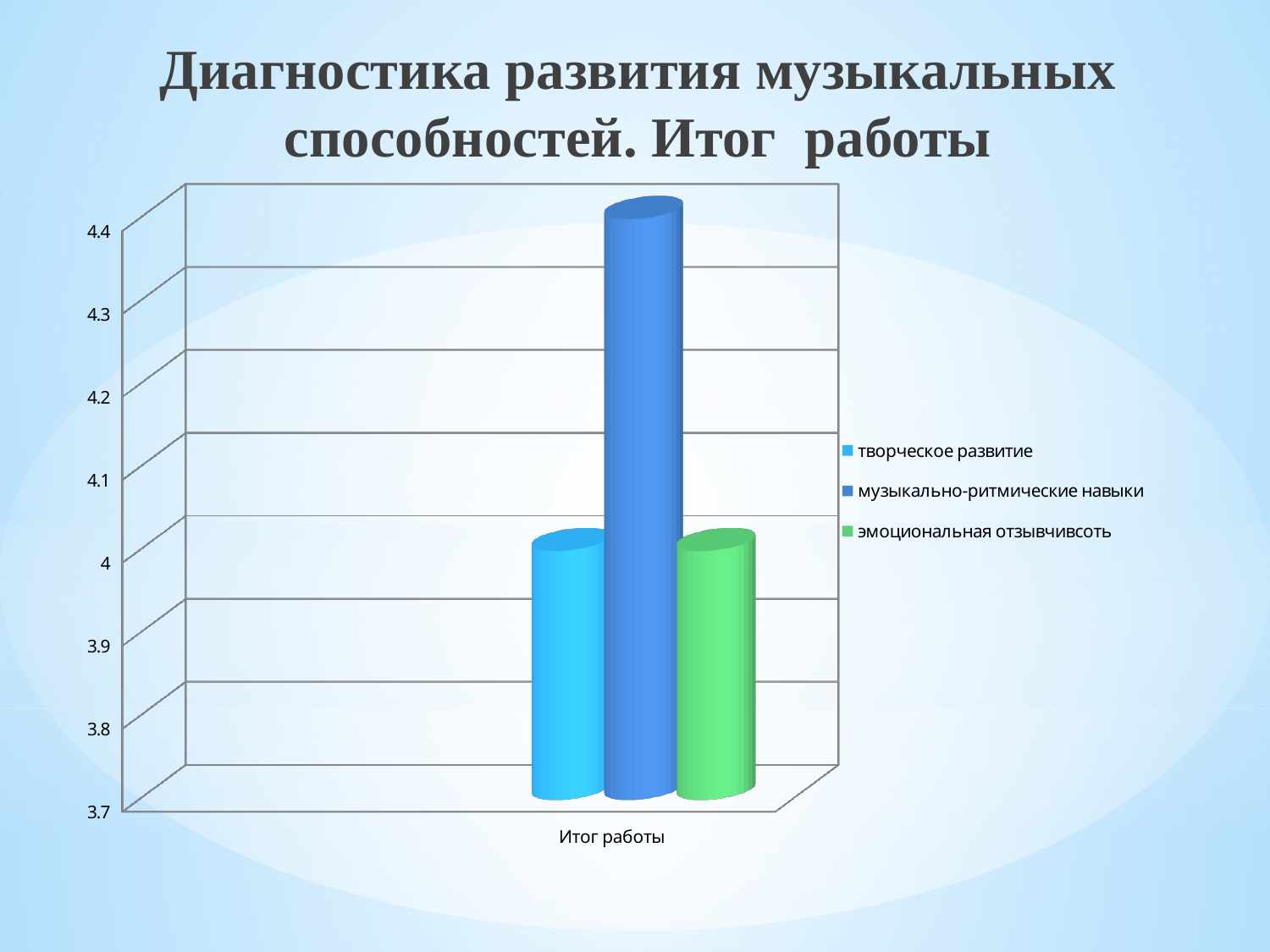
Which series is shown in green? эмоциональная отзывчивсоть Which is larger, the value for музыкально-ритмические навыки or the value for творческое развитие? музыкально-ритмические навыки Is the value for творческое развитие greater or less than 4.2? less What kind of chart is shown on the slide? bar chart Is the value for музыкально-ритмические навыки greater or less than 4.3? greater Which is larger, the value for эмоциональная отзывчивость or the value for музыкально-ритмические навыки? музыкально-ритмические навыки Which series has the highest value? музыкально-ритмические навыки How many categories are shown on the x axis? 1 What is the category label on the x axis? Итог работы Is the value for эмоциональная отзывчивость greater or less than 3.9? greater How many series does the legend list? 3